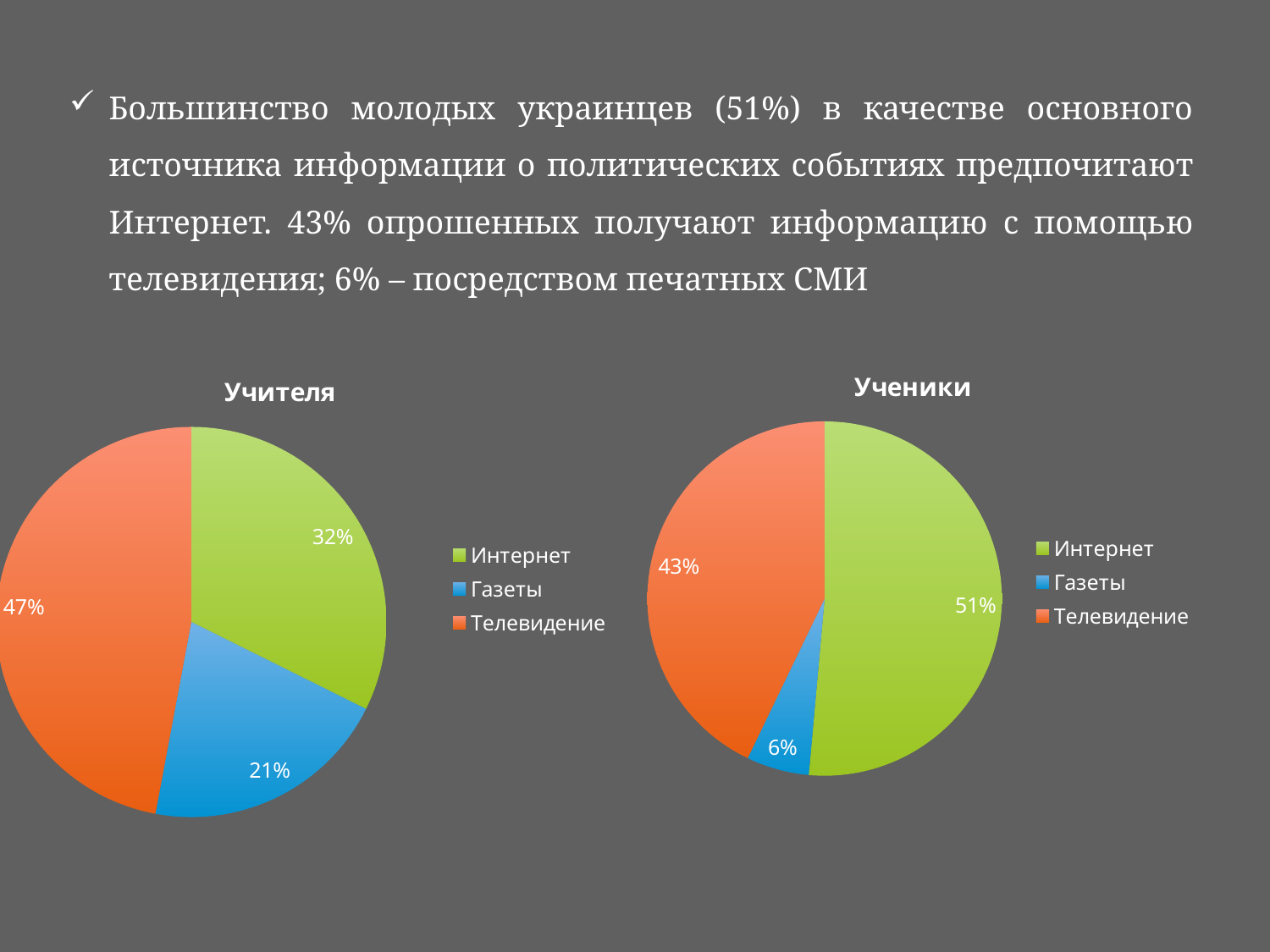
In the "Ученики" chart, what is the value for Газеты? 6% In the "Ученики" chart, what colour is the Телевидение slice? Orange In the "Ученики" chart, which category has the smallest slice? Газеты How many categories does the "Ученики" chart show? 3 In the "Учителя" chart, what is the difference between Интернет and Газеты? 11% In the "Ученики" chart, what is the value for Интернет? 51% In the "Ученики" chart, what is the difference between Интернет and Телевидение? 8% In the "Учителя" chart, what is the value for Газеты? 21% In the "Учителя" chart, which category has the largest slice? Телевидение What kind of chart is the "Учителя" chart? Pie chart In the "Учителя" chart, which is larger, Интернет or Телевидение? Телевидение In the "Учителя" chart, what is the value for Телевидение? 47%